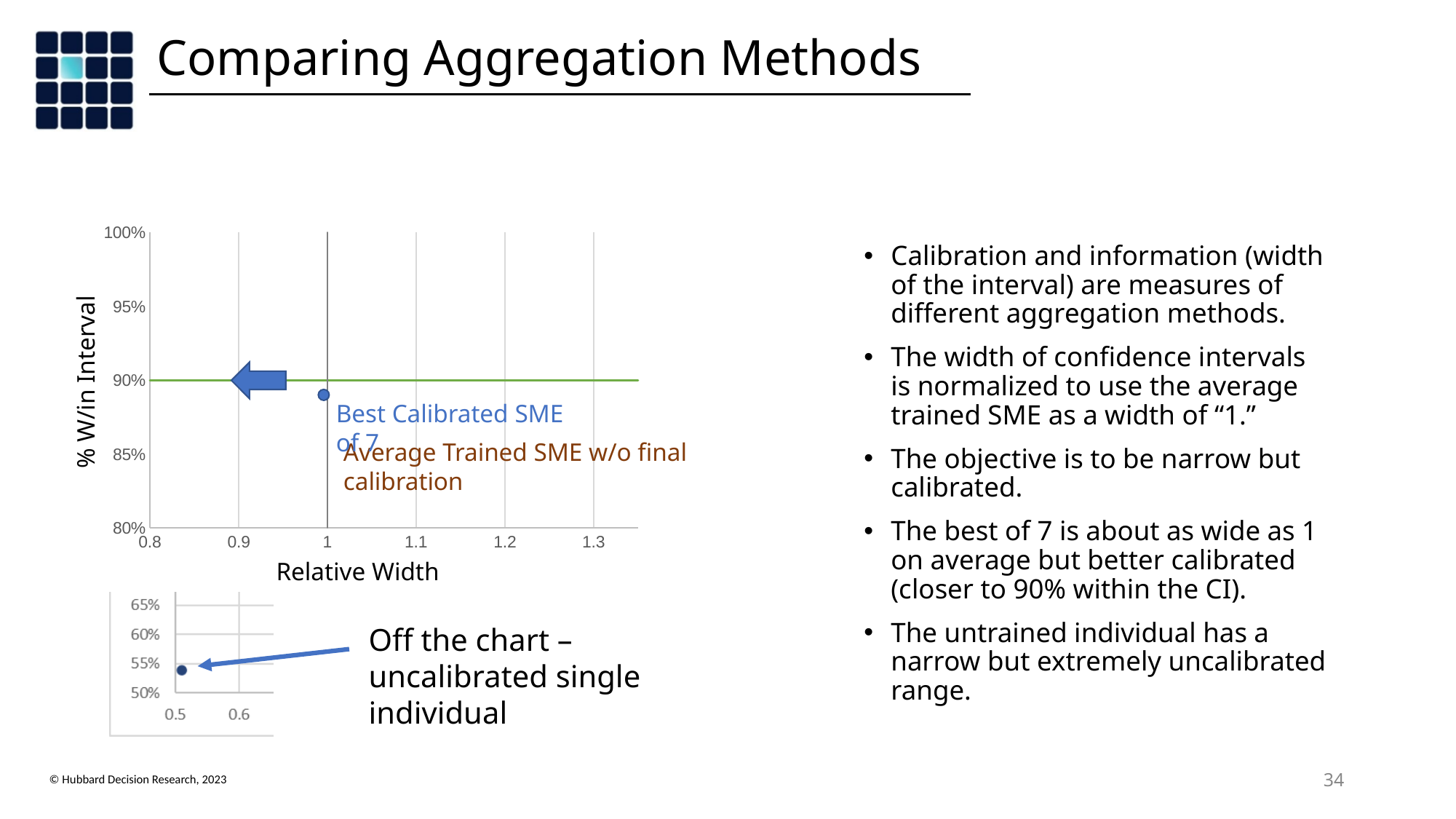
In the main chart, is the % W/in Interval value for the Best Calibrated SME of 7 point greater or less than 90%? less In the main chart, what is the title of the x axis? Relative Width In the small inset chart at the bottom left, is the value for the uncalibrated single individual greater or less than 60%? less In the main chart, what is the title of the y axis? % W/in Interval What kind of chart is the main chart on the slide? scatter chart Which point has the higher % W/in Interval: the Best Calibrated SME of 7 in the main chart or the uncalibrated single individual in the inset chart? Best Calibrated SME of 7 In the main chart, is the % W/in Interval value for the Best Calibrated SME of 7 point greater or less than 85%? greater How many data points are plotted in the main chart? 1